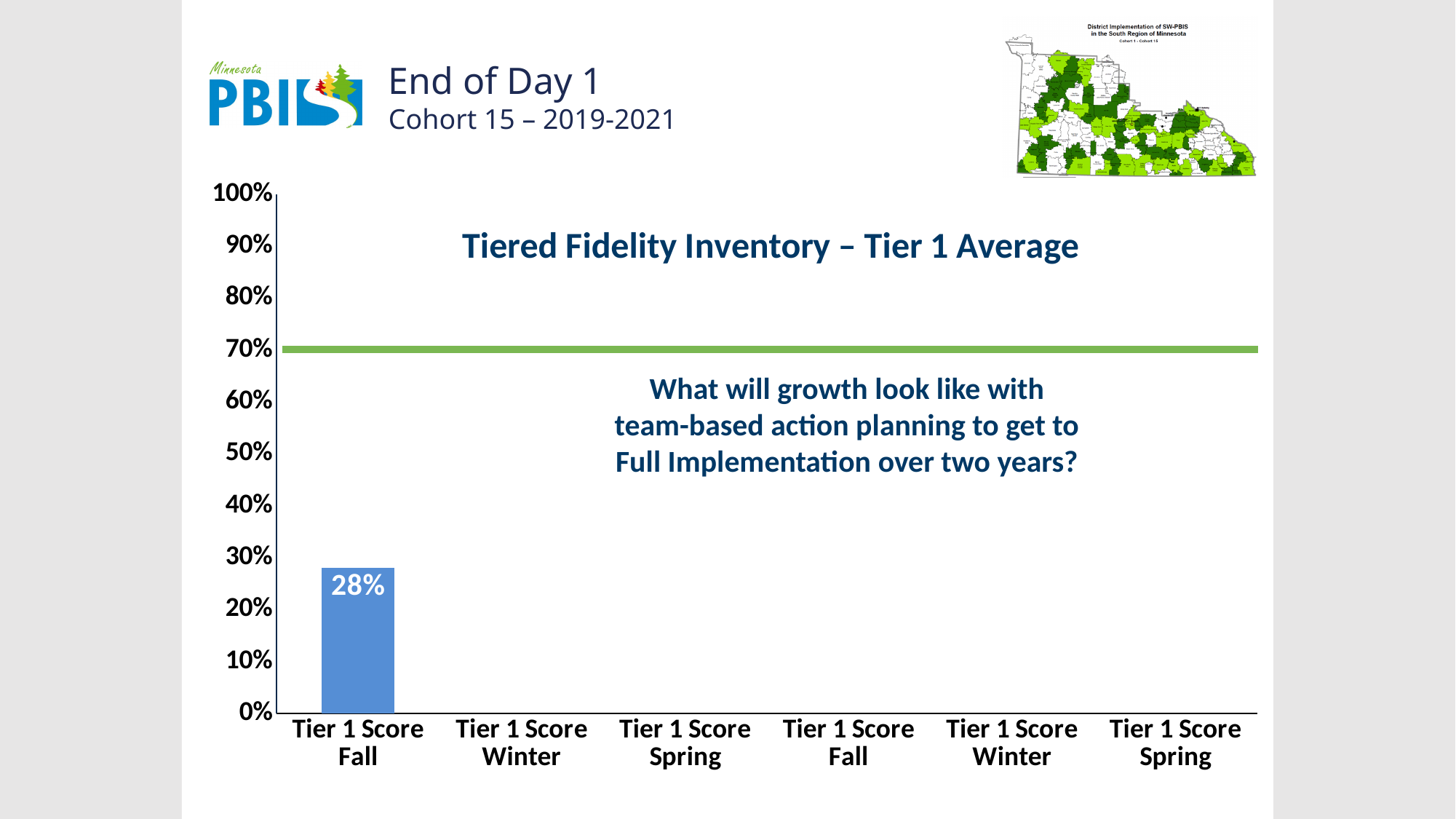
How many bars actually have a plotted value in the chart? 1 At what level is the green horizontal reference line drawn? 70% How many percentage points below the 70% reference line is the first Tier 1 Score Fall bar? 42 percentage points What kind of chart is shown on the slide? bar chart What is the title of the chart? Tiered Fidelity Inventory – Tier 1 Average What is the value of the first Tier 1 Score Fall bar? 28% Is the value for the first Tier 1 Score Fall bar greater or less than 20%? greater How many categories are listed along the x axis? 6 Is the value for the first Tier 1 Score Fall bar greater or less than 30%? less Which category is the only one with a plotted bar? Tier 1 Score Fall (first) What is the maximum value shown on the y axis? 100%